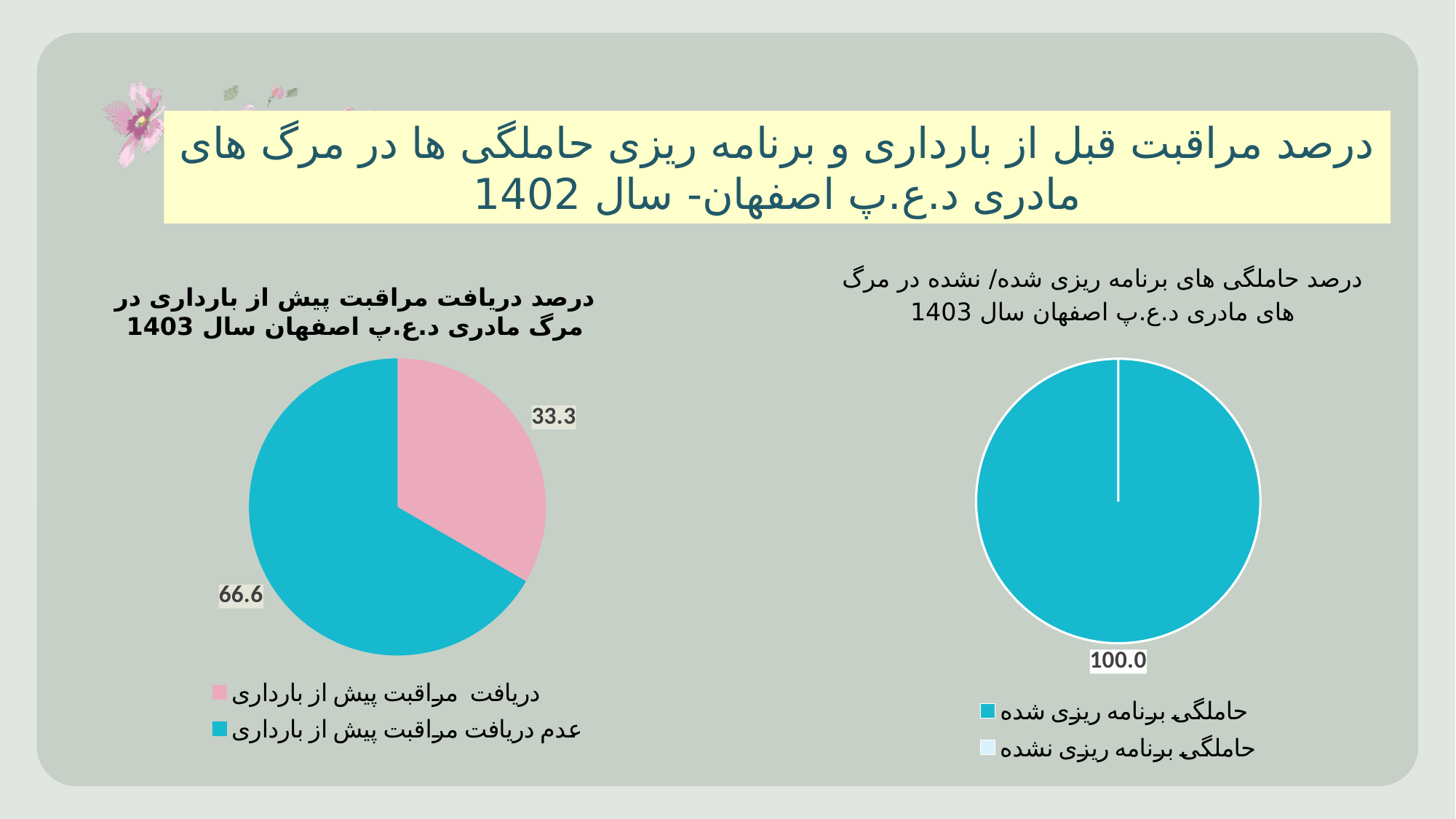
What kind of chart is the right chart on the slide? Pie chart In the left pie chart, what is the difference between the values for 'عدم دریافت مراقبت پیش از بارداری' and 'دریافت مراقبت پیش از بارداری'? 33.3 How many entries does the legend of the left pie chart list? 2 In the left pie chart, what is the value for 'دریافت مراقبت پیش از بارداری'? 33.3 In the right pie chart, what is the value shown for 'حاملگی برنامه ریزی شده'? 100.0 In the left pie chart, which category has the smallest slice? دریافت مراقبت پیش از بارداری In the left pie chart, what is the value for 'عدم دریافت مراقبت پیش از بارداری'? 66.6 How many entries does the legend of the right pie chart list? 2 What kind of chart is the left chart on the slide? Pie chart In the left pie chart, what colour is the slice for 'دریافت مراقبت پیش از بارداری'? Pink In the left pie chart, which category has the largest slice? عدم دریافت مراقبت پیش از بارداری In the left pie chart, which is larger: 'دریافت مراقبت پیش از بارداری' or 'عدم دریافت مراقبت پیش از بارداری'? عدم دریافت مراقبت پیش از بارداری